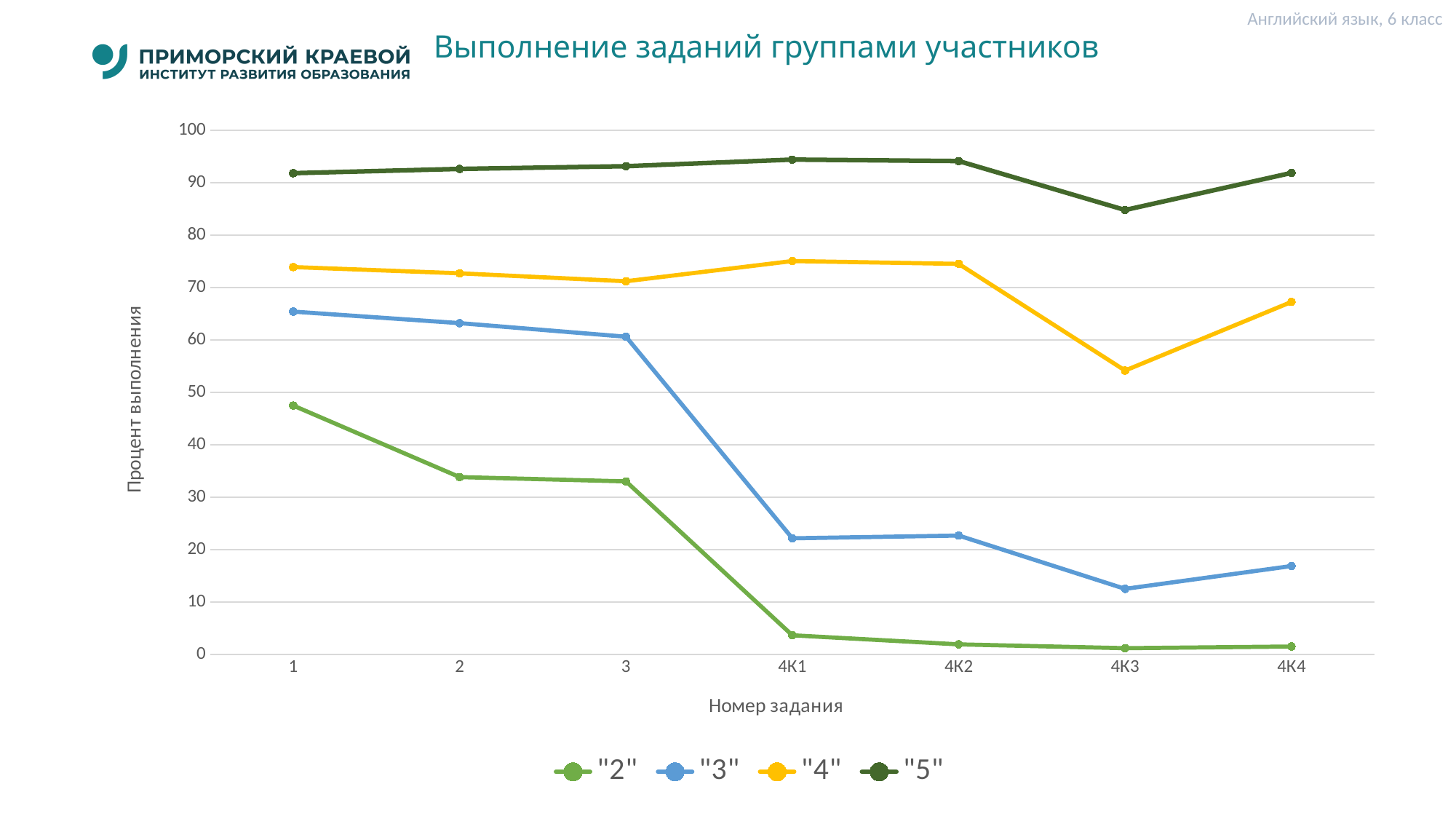
Is the value for series "2" at task 4К1 greater or less than 10? less Is the value for series "4" at task 4К3 greater or less than 50? greater How many series does the legend list? 4 Does the value for series "2" rise or fall from task 1 to task 4К3? fall Is the value for series "3" at task 4К1 greater or less than 20? greater What kind of chart is shown on the slide? line chart For series "5", at which task number is the value lowest? 4К3 How many task numbers are shown along the x axis? 7 At task 4К3, which series has the larger value, "4" or "5"? "5" What is the title of the vertical axis? Процент выполнения For series "2", at which task number is the value highest? 1